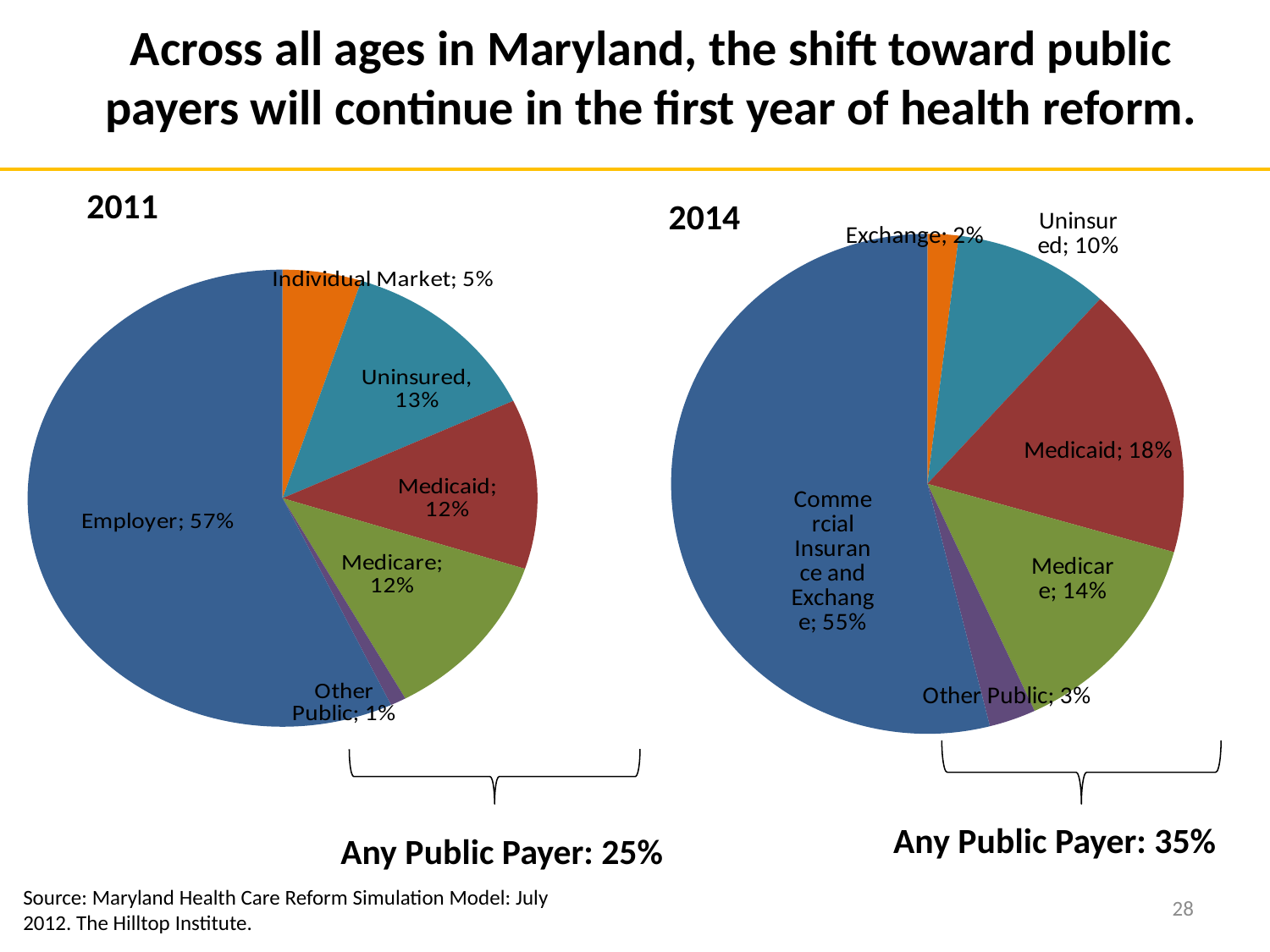
What is the difference between the Medicaid share in 2014 and the Medicaid share in 2011? 6 percentage points In the 2014 pie chart, which category has the largest share? Commercial Insurance and Exchange In the 2014 pie chart, what share does Other Public have? 3% What is the Any Public Payer figure shown under the 2014 pie chart? 35% How many slices does the 2011 pie chart have? 6 What kind of charts are shown on the slide? Pie charts In the 2014 pie chart, what share does Medicaid have? 18% In the 2011 pie chart, what share does Uninsured have? 13% In the 2011 pie chart, what share does Employer have? 57% In the 2011 pie chart, which category has the smallest share? Other Public In the 2014 pie chart, which category has the smallest share? Exchange Which is larger: the Uninsured share in 2011 or the Uninsured share in 2014? 2011